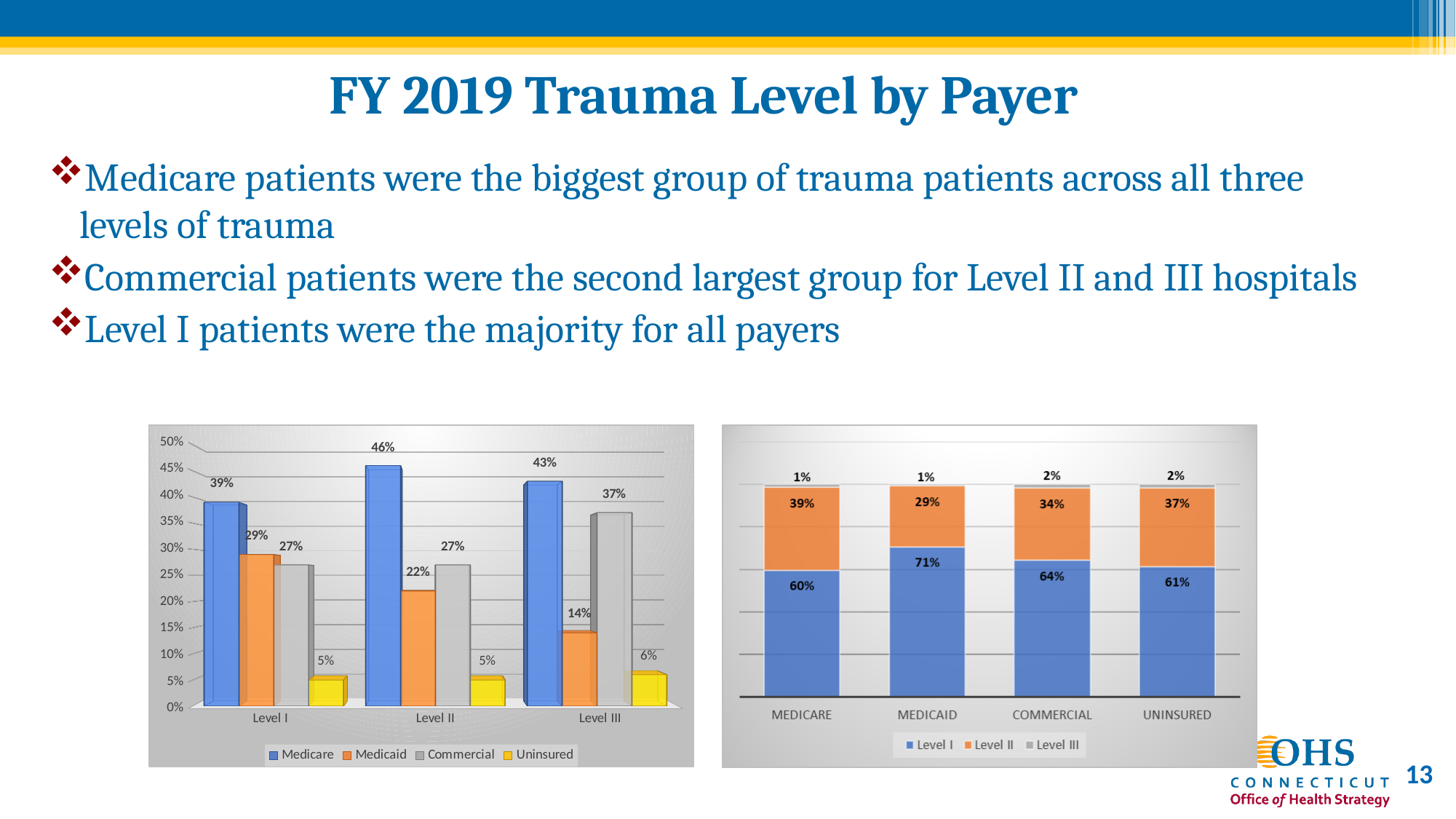
In the left chart, what is the Medicare value for Level II? 46% In the left chart, which payer has the lowest value for Level I? Uninsured In the left chart, what is the difference between the Medicare and Medicaid values for Level III? 29% In the left chart, how many series does the legend list? 4 What kind of chart is the chart on the right? Stacked bar chart In the right chart, what is the Level II value for Uninsured? 37% In the right chart, how many payer categories are shown on the x axis? 4 In the right chart, what is the total of the Commercial stacked bar? 100% In the right chart, what is the Level I value for Medicaid? 71% In the right chart, which payer has the highest Level I share? Medicaid In the left chart, which is larger for Level II: Medicaid or Commercial? Commercial In the left chart, what is the Commercial value for Level III? 37%